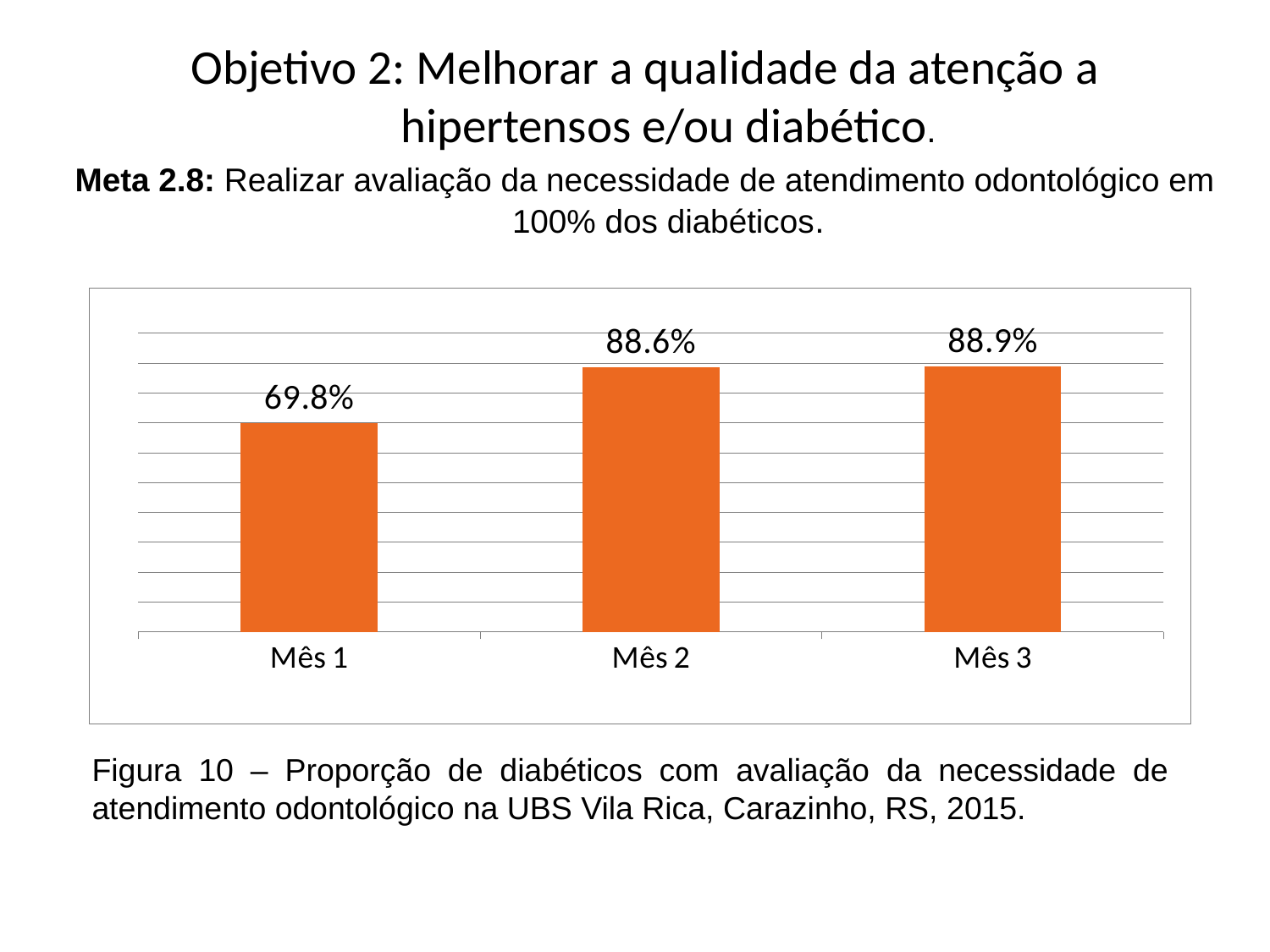
What is the value for Mês 3? 88.9% What is the value for Mês 2? 88.6% What is the difference between the values for Mês 3 and Mês 1? 19.1 percentage points What colour are the bars in the chart? Orange Which month has the highest value? Mês 3 Which is larger, the value for Mês 1 or the value for Mês 2? Mês 2 What is the value for Mês 1? 69.8% Which month has the lowest value? Mês 1 How many months are shown on the x axis? 3 Do the values rise or fall from Mês 1 to Mês 3? Rise What is the difference between the values for Mês 2 and Mês 1? 18.8 percentage points What kind of chart is shown on the slide? Bar chart